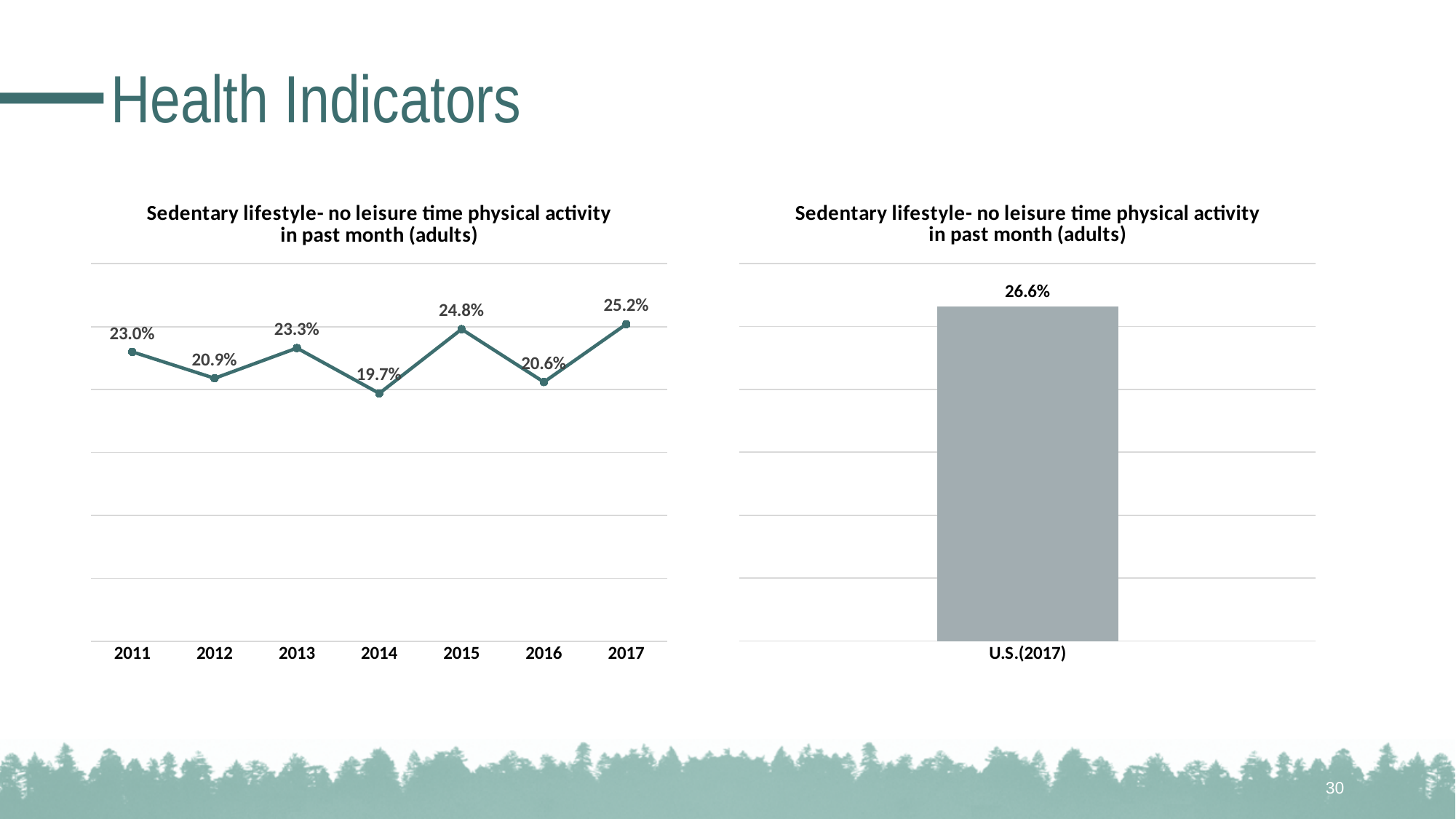
In the right chart (bar chart), what is the value for U.S.(2017)? 26.6% Is the 2017 value in the left chart (line chart) larger or smaller than the U.S.(2017) value in the right chart? smaller In the left chart (line chart), what is the difference between the 2015 value and the 2016 value? 4.2% In the left chart (line chart), which is larger, the value for 2011 or the value for 2013? 2013 How many years are plotted in the left chart (line chart)? 7 What is the title of the right chart? Sedentary lifestyle- no leisure time physical activity in past month (adults) What kind of chart is the chart on the right of the slide? bar chart In the left chart (line chart), what is the value for 2017? 25.2% What kind of chart is the chart on the left of the slide? line chart In the left chart (line chart), what is the value for 2014? 19.7% In the left chart (line chart), which year has the lowest value? 2014 In the left chart (line chart), which year has the highest value? 2017